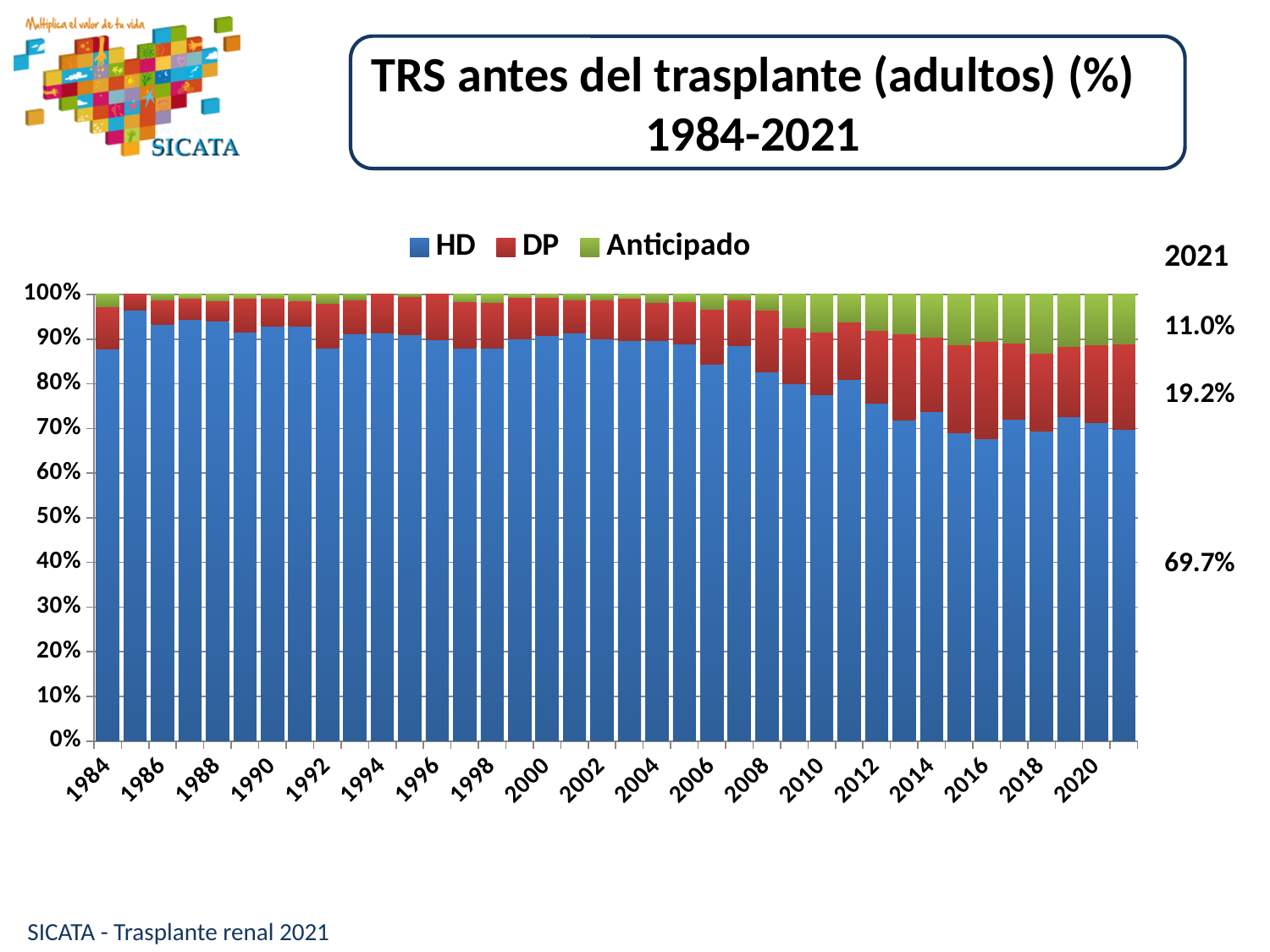
What kind of chart is shown on the slide? Stacked bar chart What is the difference in percentage points between the DP and Anticipado shares in 2021? 8.2 How many series does the legend list? 3 Is the HD share in 1984 greater or less than 80%? greater What is the HD share for 2021 according to the labels on the right of the chart? 69.7% What is the DP share for 2021 according to the labels on the right of the chart? 19.2% Which series has the largest share in 2021? HD Does the HD share generally rise or fall from 1984 to 2021? Fall Is the HD share in 2016 greater or less than 70%? less Which is larger, the HD share in 1985 or the HD share in 2017? HD share in 1985 What is the Anticipado share for 2021 according to the labels on the right of the chart? 11.0% Which series has the smallest share in 2021? Anticipado